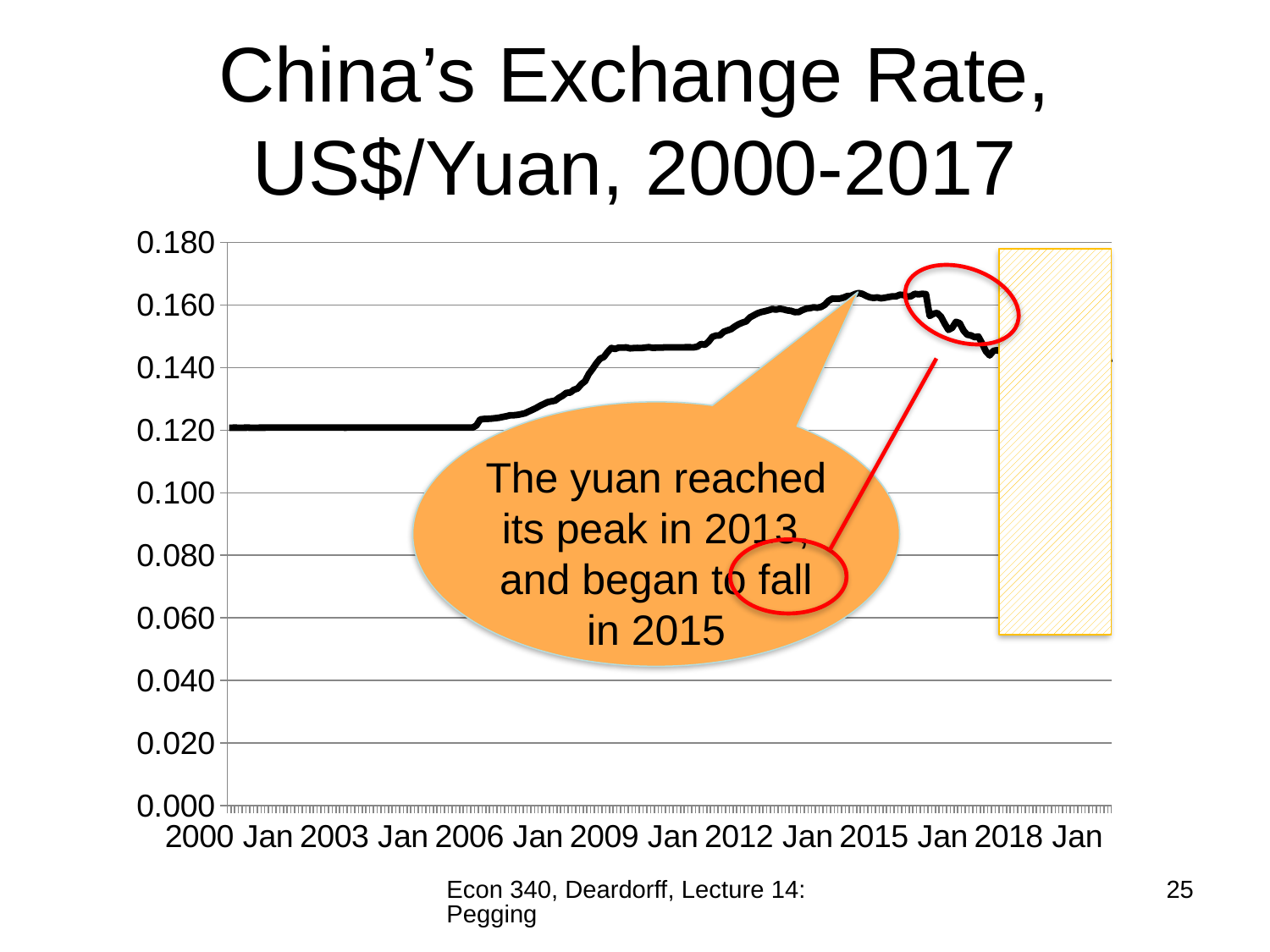
What kind of chart is shown on the slide? line chart Is the exchange rate in 2012 Jan higher or lower than in 2003 Jan? higher Is the exchange rate in 2000 Jan greater or less than 0.140? less Is the exchange rate in 2003 Jan greater or less than 0.140? less What is the title of the chart? China's Exchange Rate, US$/Yuan, 2000-2017 According to the callout on the chart, in which year did the yuan reach its peak? 2013 Does the exchange rate rise or fall between 2015 and 2017? fall According to the callout on the chart, in which year did the yuan begin to fall? 2015 What is the highest value shown on the vertical axis? 0.180 Does the exchange rate rise or fall between 2006 Jan and 2013? rise Is the exchange rate in 2012 Jan greater or less than 0.140? greater